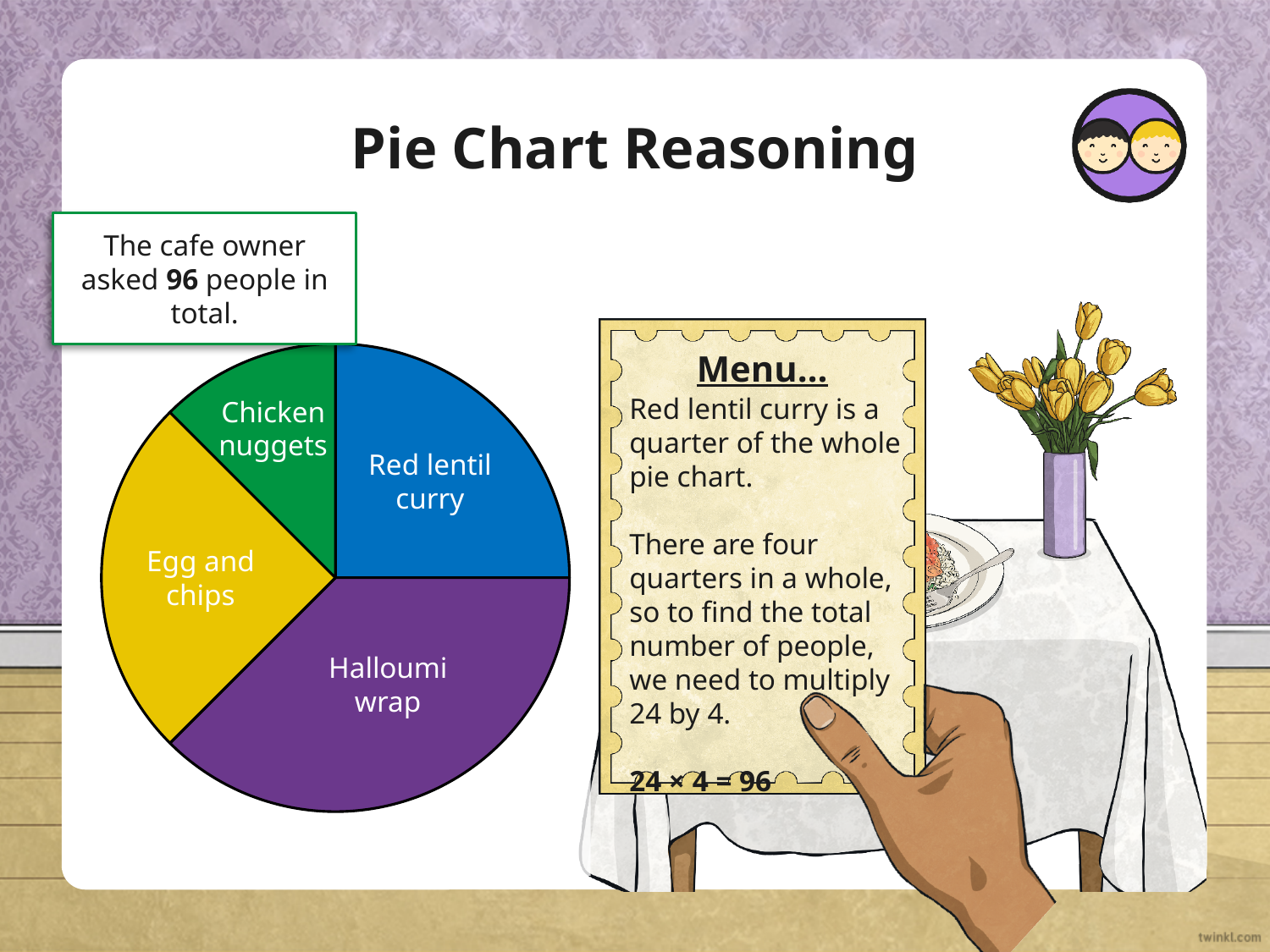
What is the title of the slide containing the pie chart? Pie Chart Reasoning Which slice is larger, Egg and chips or Chicken nuggets? Egg and chips How many people chose Red lentil curry? 24 Which menu item has the largest slice of the pie chart? Halloumi wrap Which slice is larger, Halloumi wrap or Red lentil curry? Halloumi wrap How many slices does the pie chart have? 4 What colour is the Egg and chips slice? yellow What kind of chart is shown on the slide? pie chart Which menu item has the smallest slice of the pie chart? Chicken nuggets What fraction of the pie chart does Red lentil curry represent? a quarter Which slice is larger, Halloumi wrap or Chicken nuggets? Halloumi wrap How many people in total did the cafe owner ask? 96